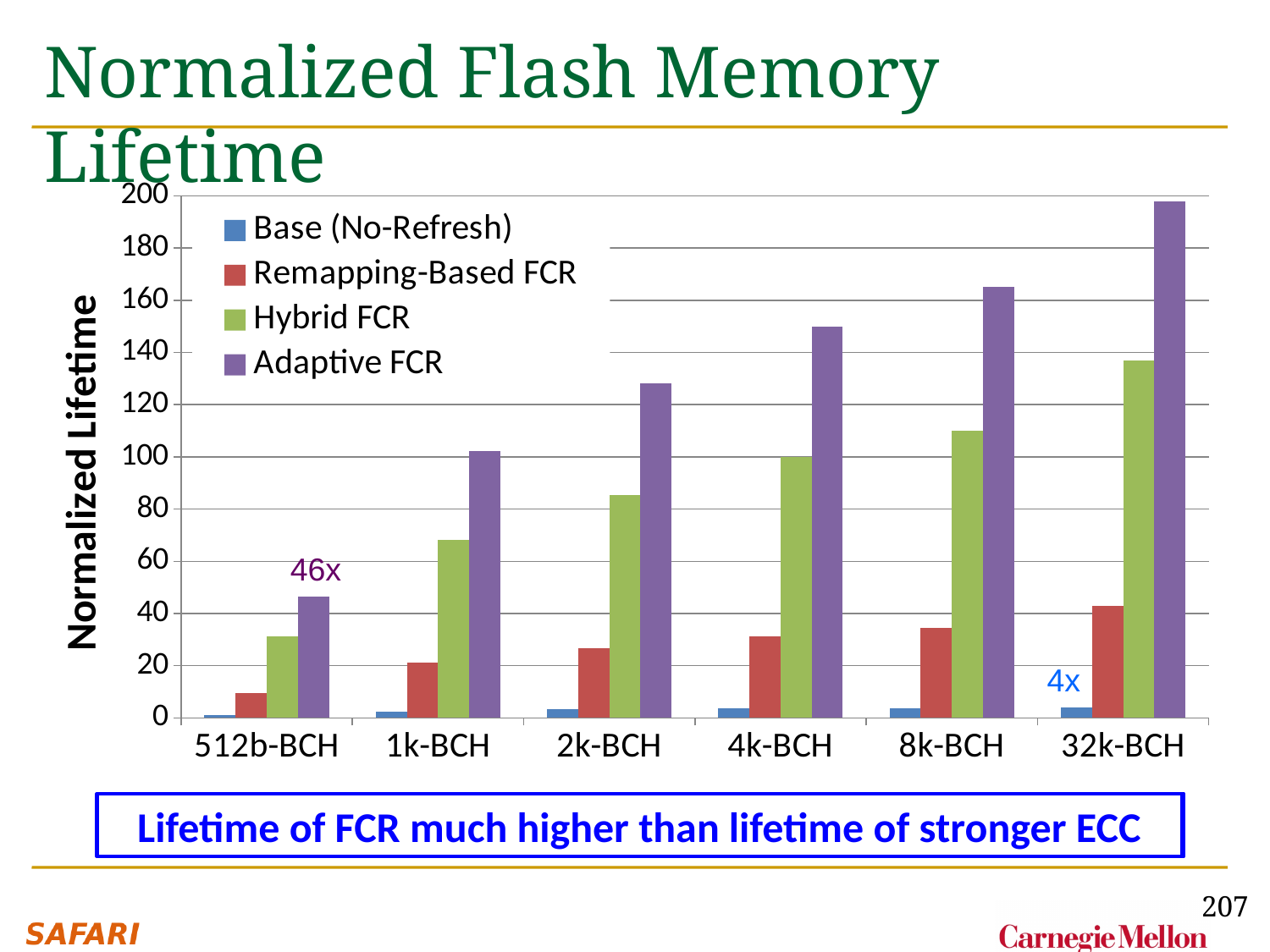
How many categories are shown on the x axis? 6 Is the value for Base (No-Refresh) at 512b-BCH greater or less than 20? less Which is larger: Hybrid FCR at 2k-BCH or Remapping-Based FCR at 32k-BCH? Hybrid FCR at 2k-BCH For which category is the Adaptive FCR value highest? 32k-BCH What kind of chart is shown on the slide? bar chart Is the value for Adaptive FCR at 32k-BCH greater or less than 180? greater Is the value for Adaptive FCR at 2k-BCH greater or less than 120? greater Which series has the highest value at 32k-BCH? Adaptive FCR How many series does the legend list? 4 Do the Adaptive FCR values rise or fall from 512b-BCH to 32k-BCH? rise Which series has the lowest value at 512b-BCH? Base (No-Refresh)